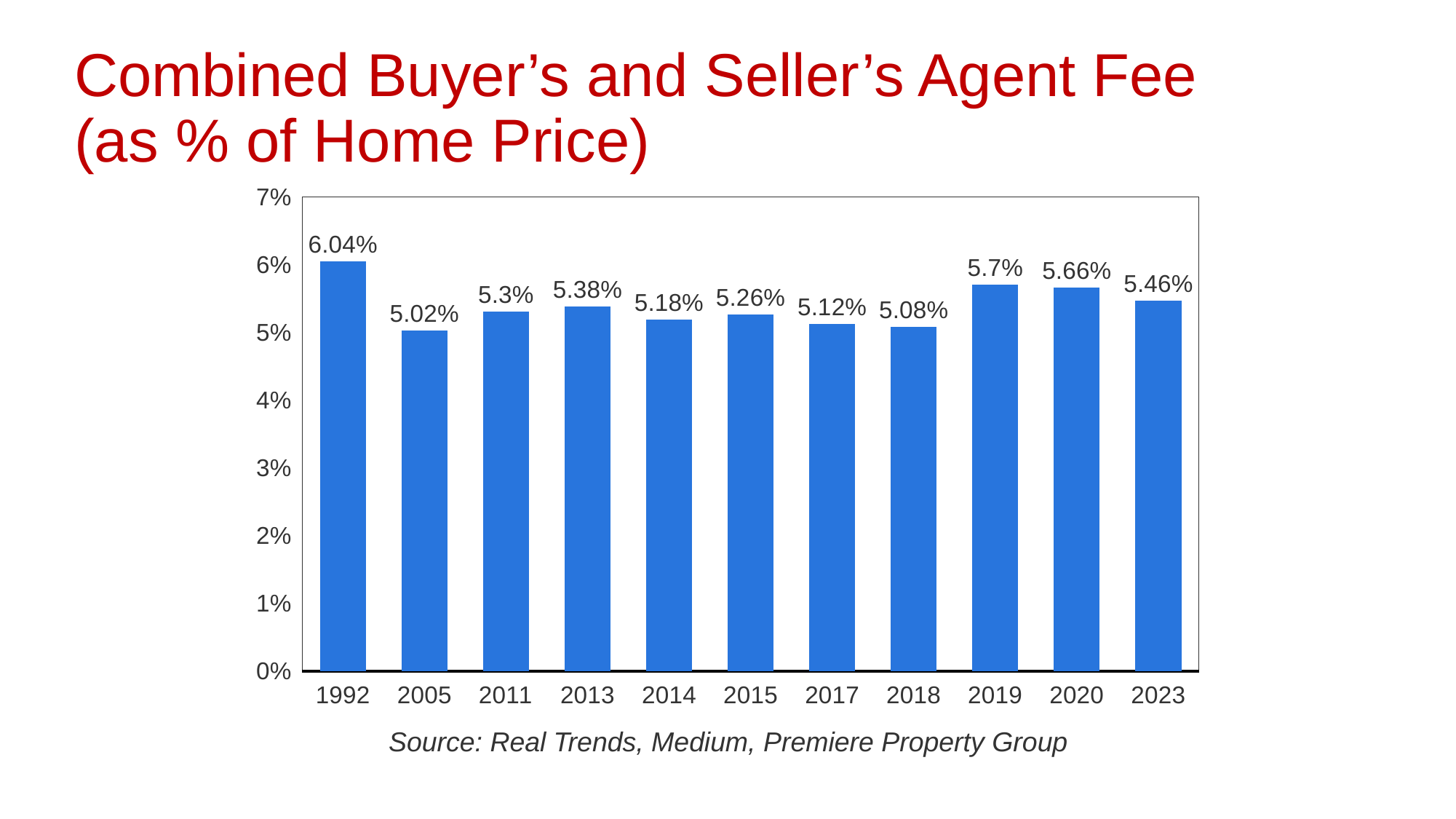
What is the combined agent fee for 2019? 5.7% What is the combined agent fee for 2023? 5.46% What is the combined agent fee for 1992? 6.04% What kind of chart is shown on the slide? Bar chart What is the source cited below the chart? Real Trends, Medium, Premiere Property Group Which year has the highest combined agent fee? 1992 Which year has a higher combined agent fee, 2013 or 2014? 2013 How many years are shown on the x axis? 11 Which year has the lowest combined agent fee? 2005 What is the difference between the fee in 2019 and the fee in 2018? 0.62% What is the difference between the fee in 1992 and the fee in 2023? 0.58% Is the value for 2005 greater or less than 6%? less